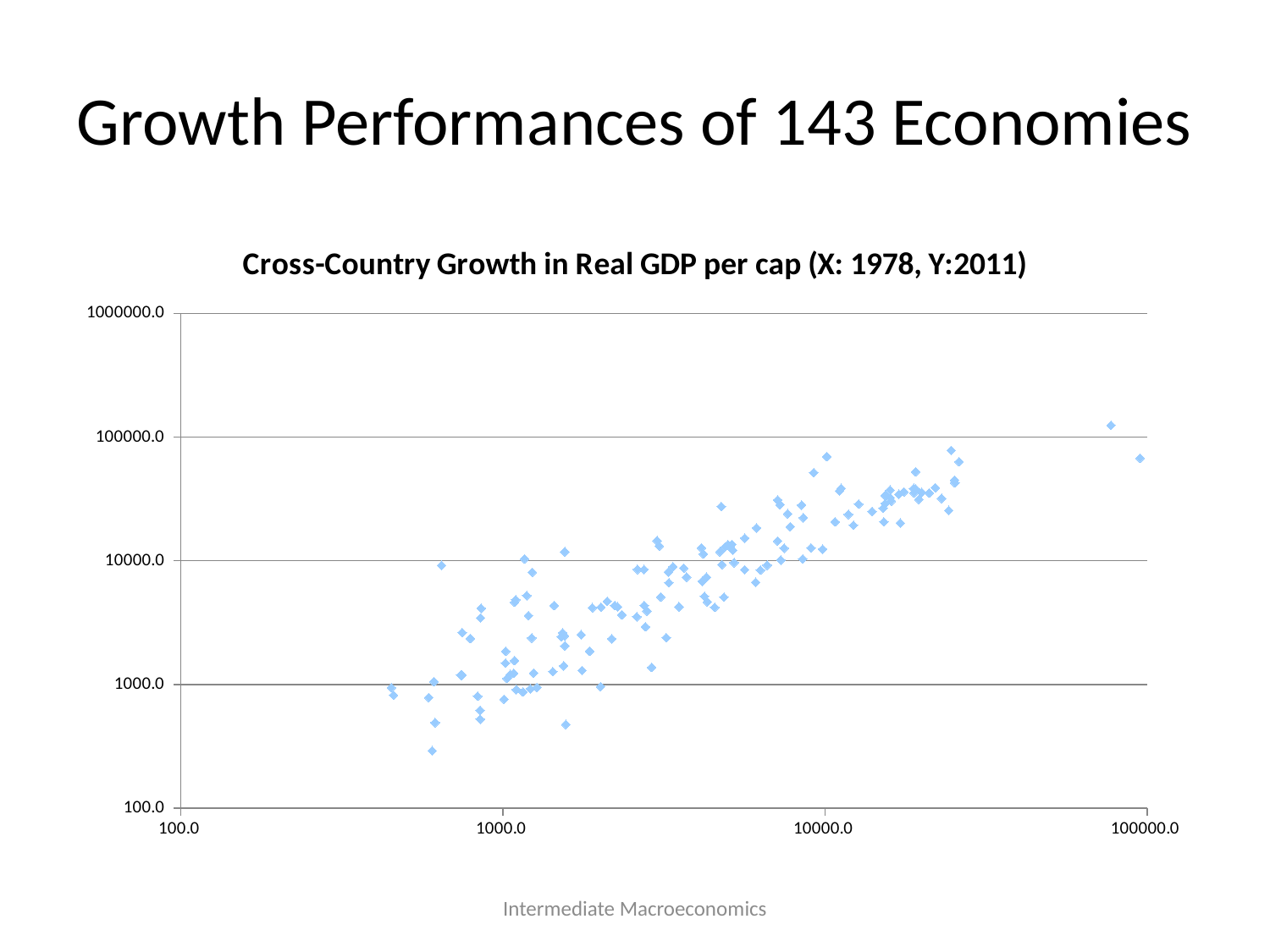
Is the highest plotted y value greater or less than 100000.0? greater Is the y value of the rightmost plotted point greater or less than 100000.0? less Is the lowest plotted y value greater or less than 1000.0? less Do the plotted y values generally rise or fall as the x values increase? rise How many economies are plotted in the chart, according to the slide title? 143 What kind of chart is shown on the slide? scatter chart What is the title of the chart? Cross-Country Growth in Real GDP per cap (X: 1978, Y:2011) What is the highest tick label shown on the y axis? 1000000.0